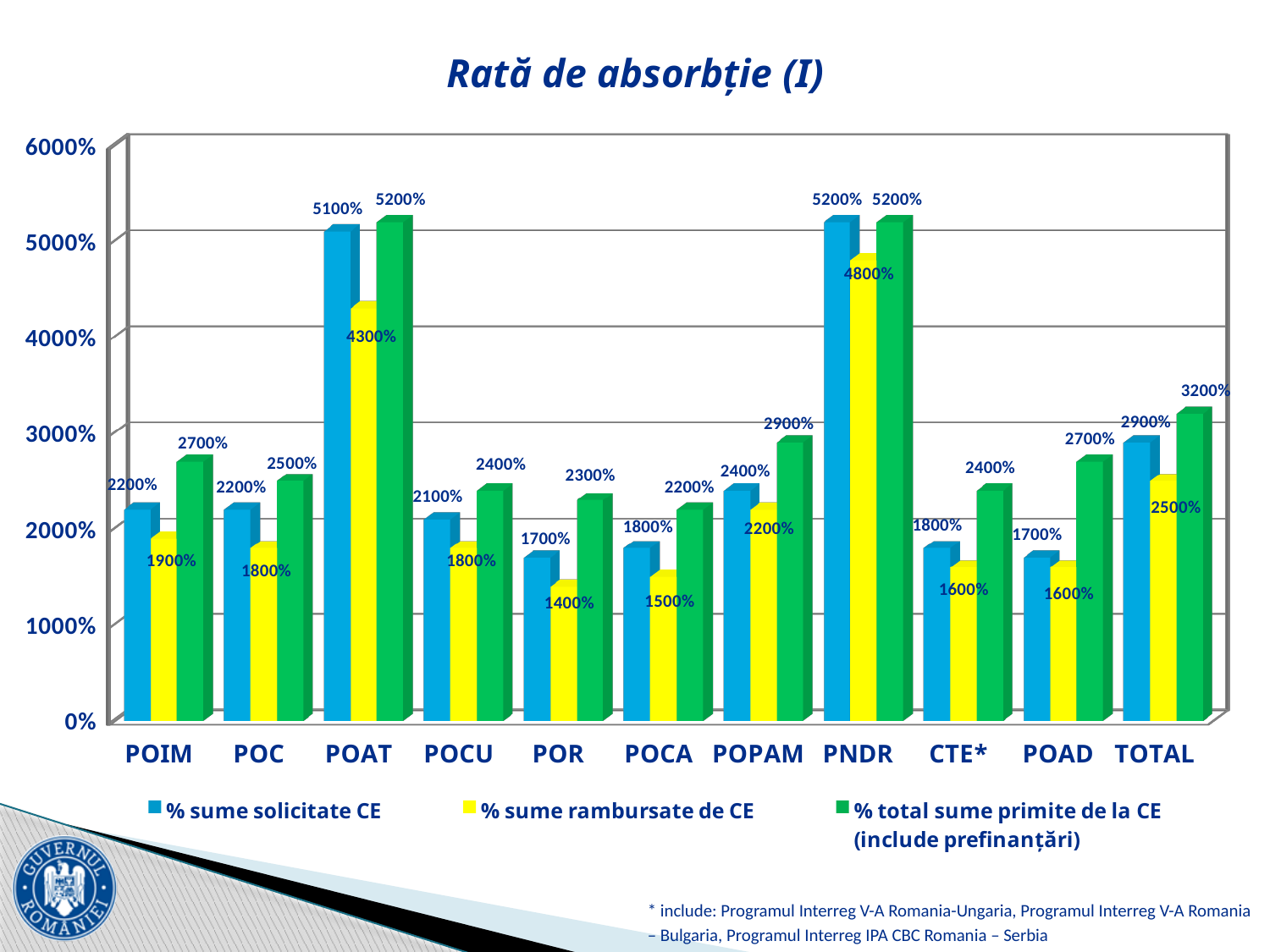
What is the difference between "% sume solicitate CE" and "% sume rambursate de CE" for POAT? 800% What is the value of "% sume rambursate de CE" for POAT? 4300% What kind of chart is shown on the slide? Bar chart What is the value of "% total sume primite de la CE (include prefinanțări)" for POAD? 2700% Which category has the highest value for "% sume rambursate de CE"? PNDR What is the value of "% sume solicitate CE" for PNDR? 5200% How many series does the legend list? 3 What is the difference between "% total sume primite de la CE (include prefinanțări)" and "% sume rambursate de CE" for TOTAL? 700% How many categories are shown on the x axis? 11 Which has a higher value for "% total sume primite de la CE (include prefinanțări)": POPAM or POCU? POPAM What is the value of "% sume solicitate CE" for CTE*? 1800% Which category has the lowest value for "% sume rambursate de CE"? POR